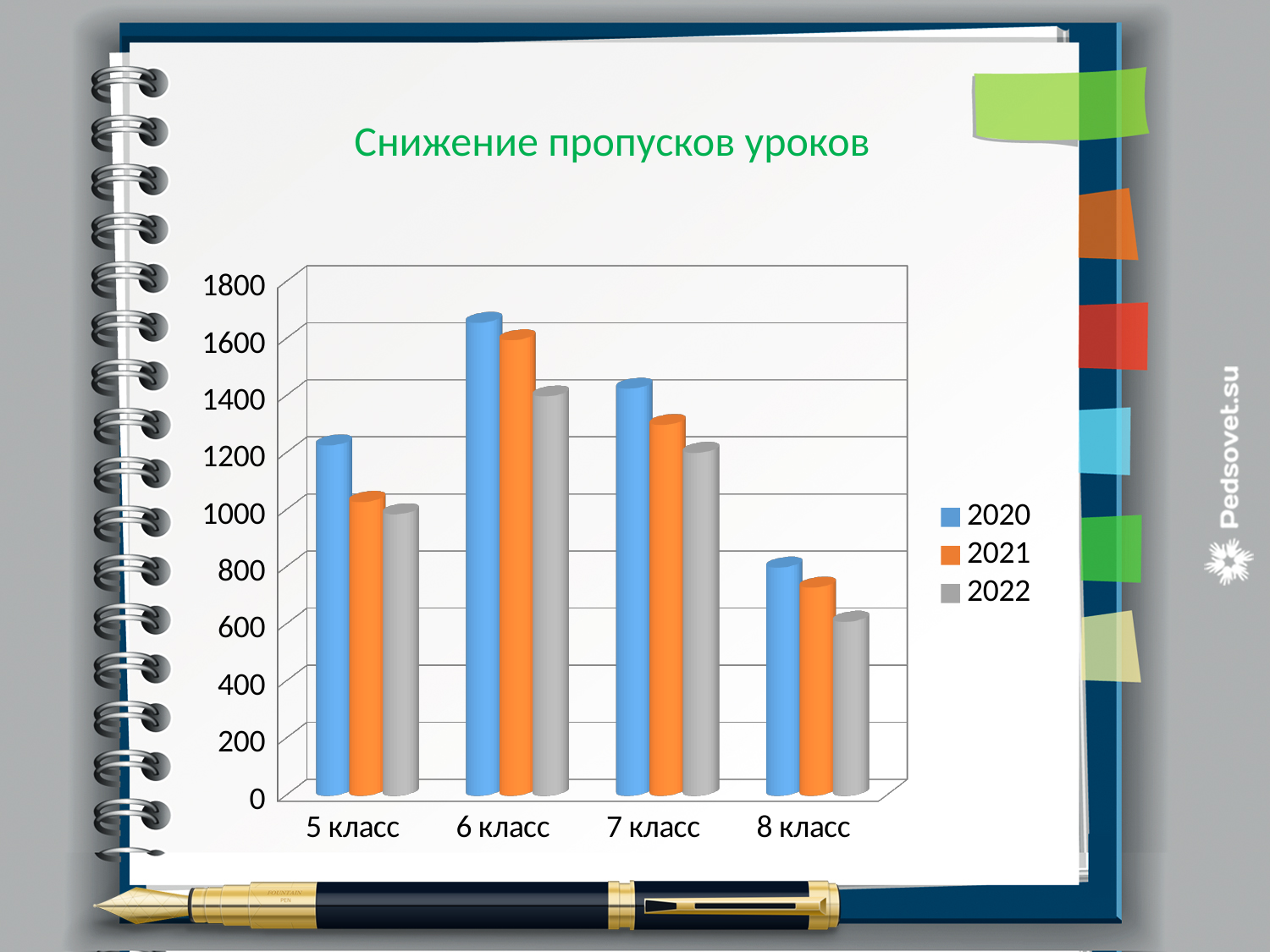
Is the value for 2022 in 8 класс greater or less than 800? less Which class has the lowest value for the 2022 series? 8 класс Is the value for 2020 in 6 класс greater or less than 1400? greater Is the value for 2020 in 5 класс greater or less than 1000? greater Which class has the highest value for the 2020 series? 6 класс How many series does the legend list? 3 How many categories (classes) are shown on the x axis? 4 For 7 класс, which series has the larger value, 2020 or 2022? 2020 What kind of chart is shown on the slide? bar chart What is the title of the chart? Снижение пропусков уроков Within each class, do the values rise or fall from 2020 to 2022? fall